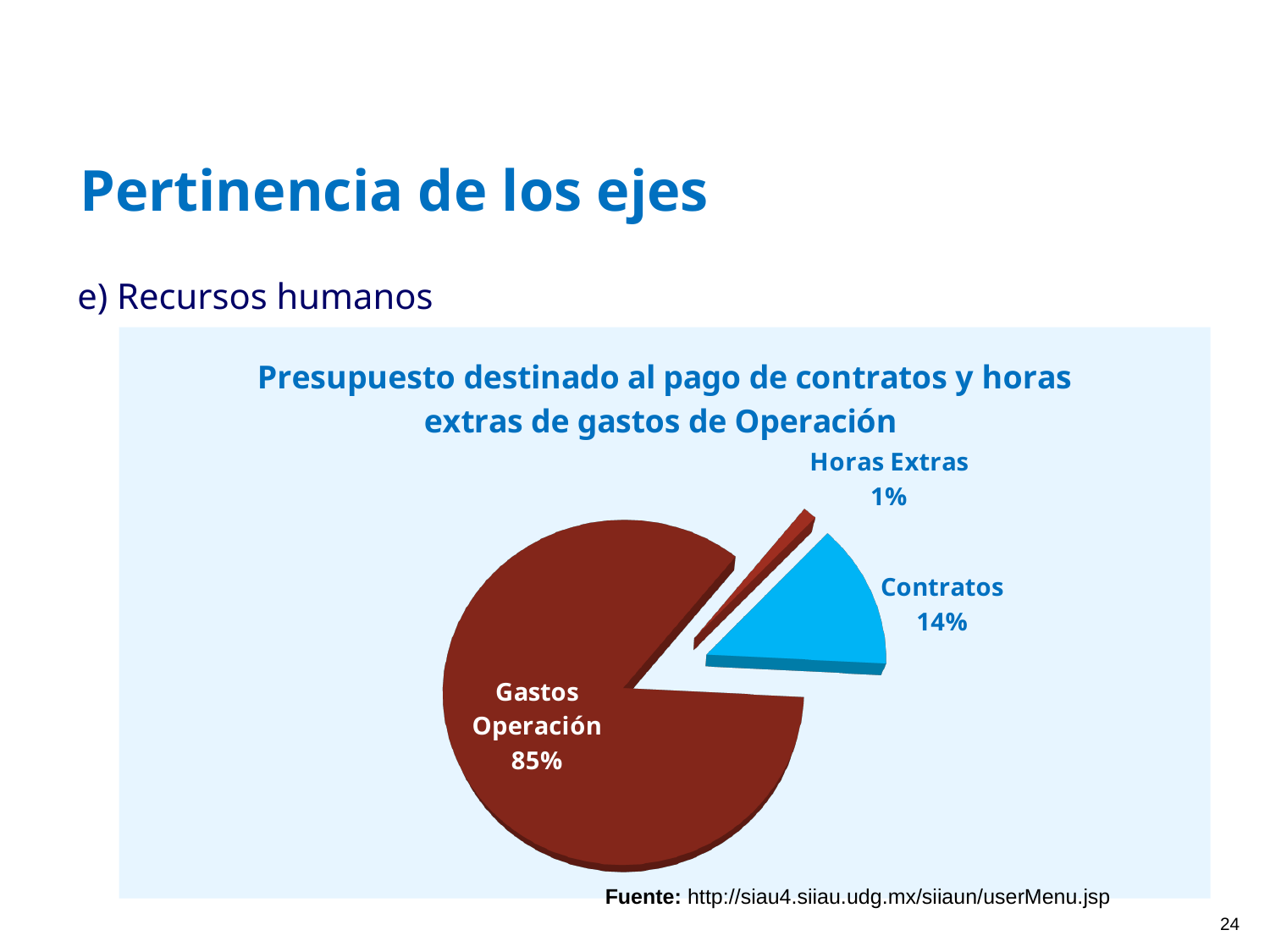
Which slice of the pie is the largest? Gastos Operación What share of the pie does Horas Extras represent? 1% What share of the pie does Contratos represent? 14% What is the title of the chart? Presupuesto destinado al pago de contratos y horas extras de gastos de Operación What share of the pie does Gastos Operación represent? 85% What is the difference in percentage points between Gastos Operación and Contratos? 71 Which is larger, Contratos or Horas Extras? Contratos What kind of chart is shown on the slide? Pie chart What colour is the Contratos slice? Blue Which slice of the pie is the smallest? Horas Extras How many slices does the pie chart have? 3 What is the difference in percentage points between Contratos and Horas Extras? 13